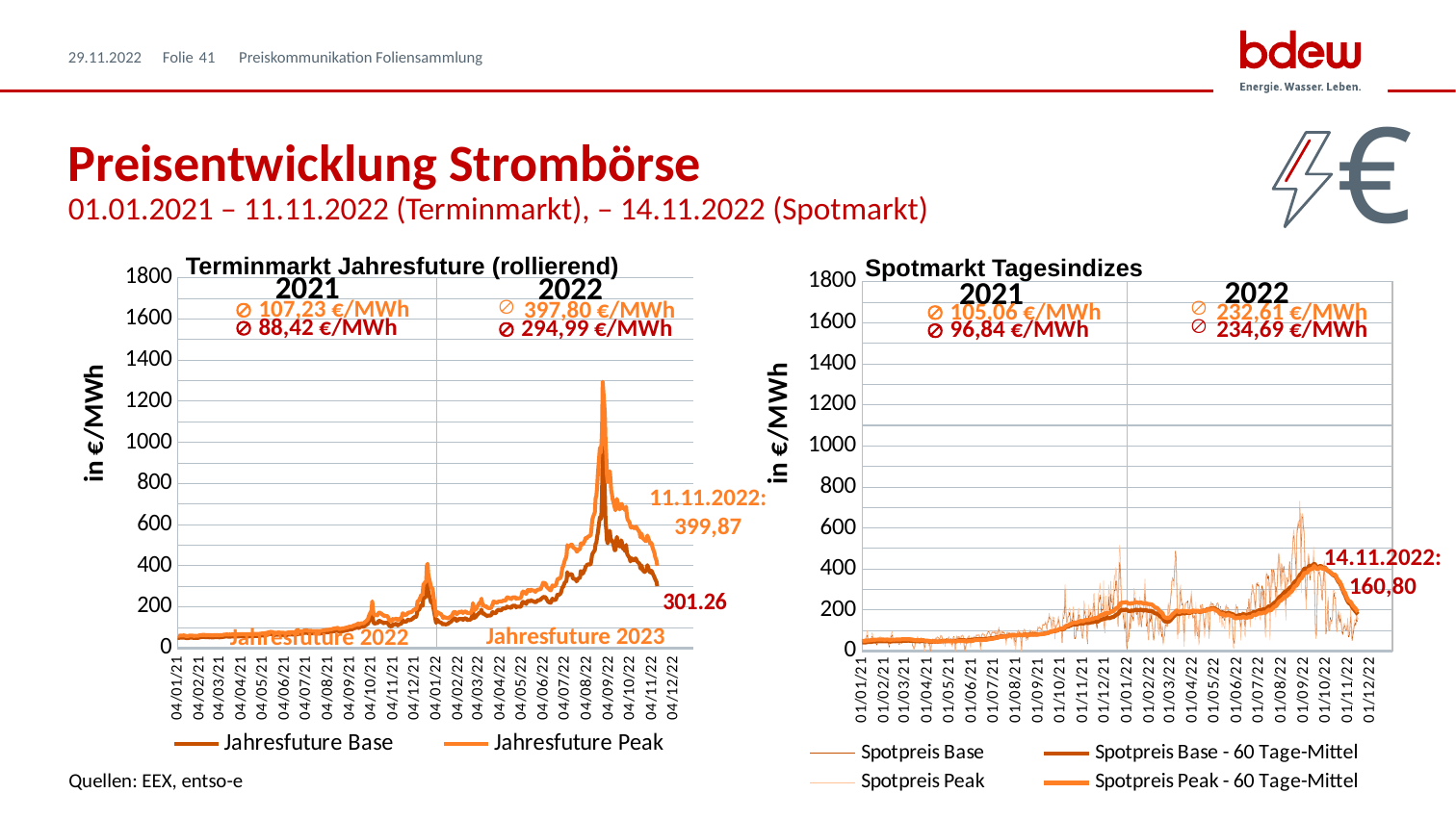
In the "Spotmarkt Tagesindizes" chart, what value is labelled for 14.11.2022? 160,80 How many series does the legend of the "Spotmarkt Tagesindizes" chart on the right list? 4 In the "Terminmarkt Jahresfuture (rollierend)" chart, what is the difference between the 2022 averages of Jahresfuture Peak (397,80 €/MWh) and Jahresfuture Base (294,99 €/MWh)? 102,81 €/MWh In the "Terminmarkt Jahresfuture (rollierend)" chart, what is the labelled value of Jahresfuture Peak on 11.11.2022? 399,87 In the "Terminmarkt Jahresfuture (rollierend)" chart, is the highest point of Jahresfuture Peak in 2022 greater or less than 1200? greater What is the y-axis label of the "Spotmarkt Tagesindizes" chart? in €/MWh How many series does the legend of the "Terminmarkt Jahresfuture (rollierend)" chart list? 2 In the "Spotmarkt Tagesindizes" chart, which 2022 average is larger: 232,61 €/MWh or 234,69 €/MWh? 234,69 €/MWh What kind of chart is the "Terminmarkt Jahresfuture (rollierend)" chart on the left? Line chart In the "Spotmarkt Tagesindizes" chart, what is the 2021 average shown in orange (Peak)? 105,06 €/MWh In the "Terminmarkt Jahresfuture (rollierend)" chart, what is the 2022 average shown for Jahresfuture Base? 294,99 €/MWh In the "Terminmarkt Jahresfuture (rollierend)" chart, what is the labelled value of Jahresfuture Base on 11.11.2022? 301.26